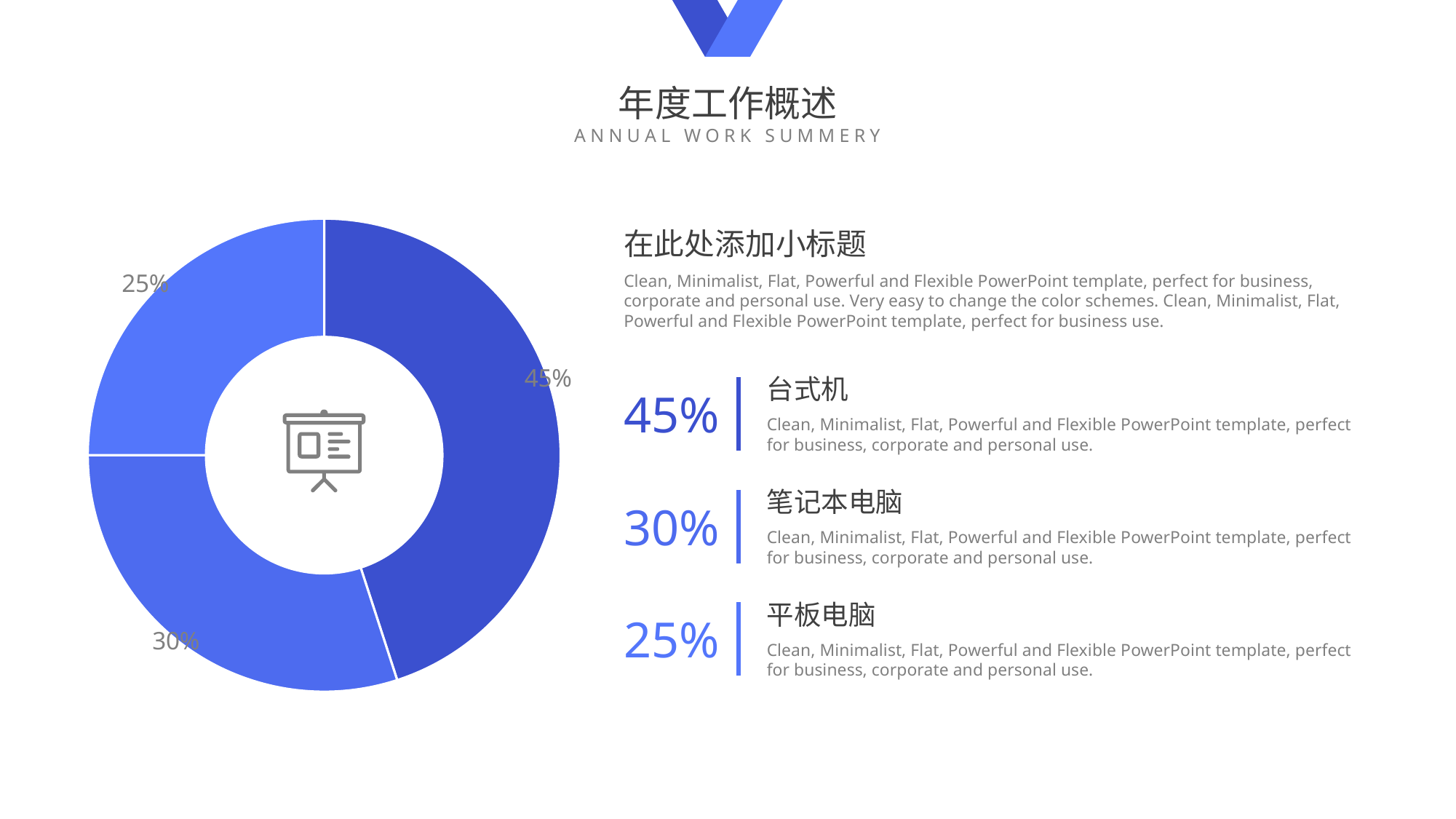
What do the three slices of the doughnut chart add up to? 100% Which is larger on the doughnut chart, the slice for 笔记本电脑 or the slice for 平板电脑? 笔记本电脑 What is the difference between the largest slice (45%) and the smallest slice (25%) of the doughnut chart? 20% How many slices does the doughnut chart have? 3 What is the difference between the 45% slice and the 30% slice of the doughnut chart? 15% According to the slide, what share does 笔记本电脑 (laptop) account for? 30% What kind of chart is shown on the slide? Doughnut chart According to the slide, what share does 台式机 (desktop) account for? 45% What is the Chinese title at the top of the slide? 年度工作概述 What is the largest value labelled on the doughnut chart? 45% According to the slide, what share does 平板电脑 (tablet) account for? 25% What is the smallest value labelled on the doughnut chart? 25%